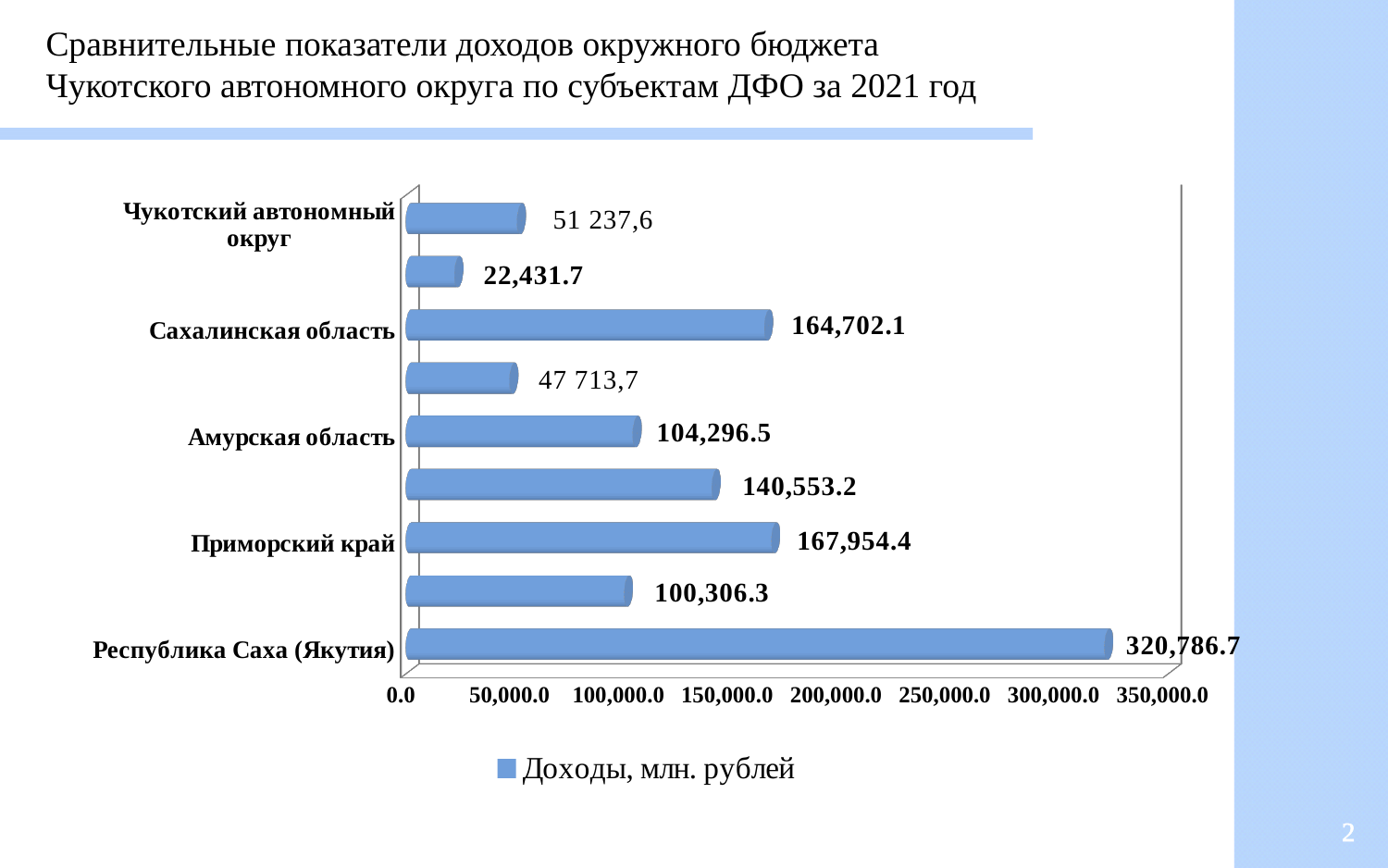
What type of chart is shown? bar chart What is the smallest value shown on the chart? 22,431.7 What is the value for Приморский край? 167,954.4 Which labeled region has the highest value? Республика Саха (Якутия) What is the value for Чукотский автономный округ? 51 237,6 What is the legend entry of the chart? Доходы, млн. рублей What is the difference between the values for Приморский край and Сахалинская область? 3,252.3 What is the value for Республика Саха (Якутия)? 320,786.7 Is the value for Чукотский автономный округ greater or less than 100,000.0? less Which is larger, the value for Амурская область or the value for Сахалинская область? Сахалинская область What is the value for Сахалинская область? 164,702.1 How many bars are shown on the chart? 9